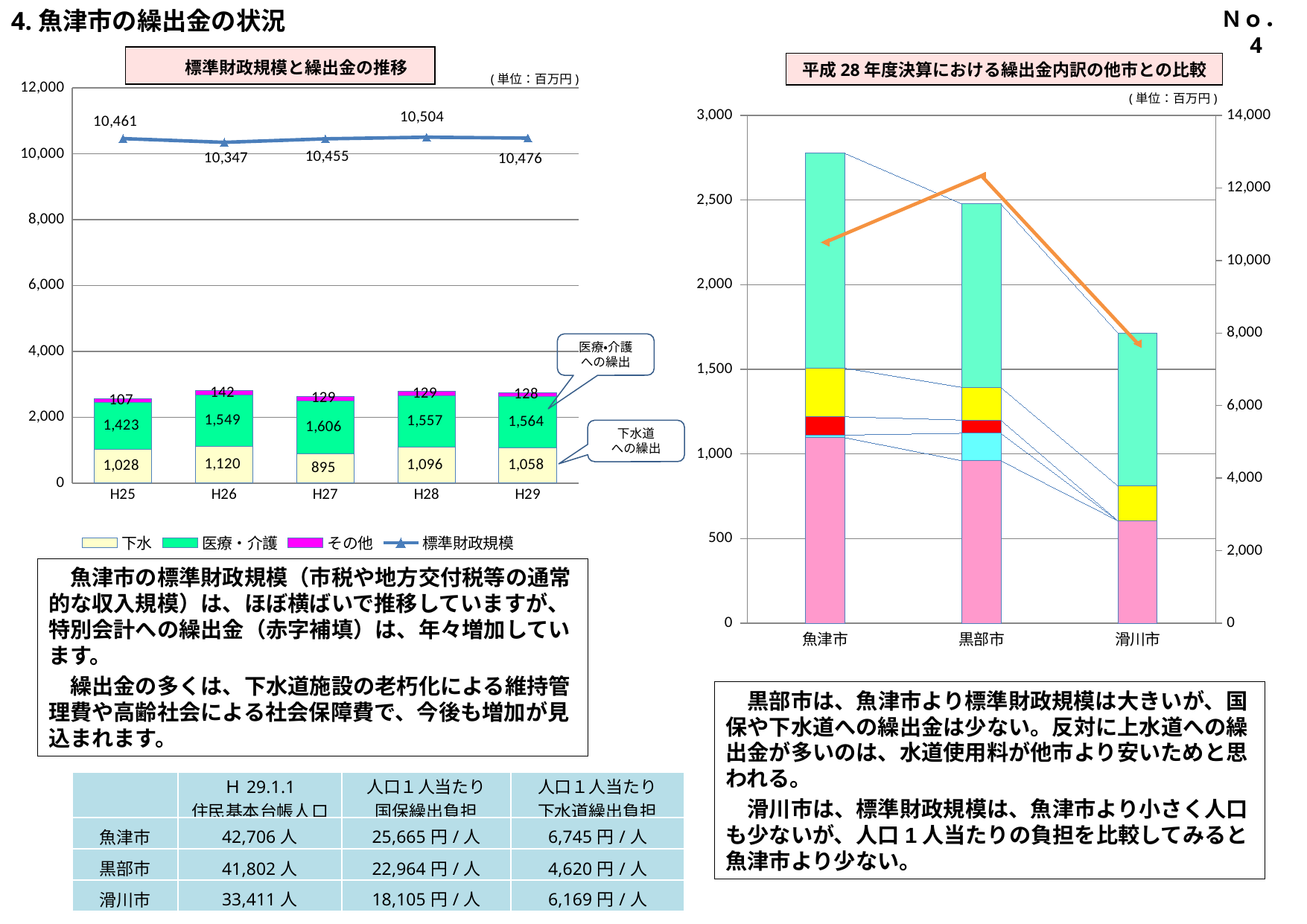
In the left chart (標準財政規模と繰出金の推移), what is the 下水 value for H27? 895 In the left chart (標準財政規模と繰出金の推移), what is the 医療・介護 value for H26? 1,549 What kind of chart is the right chart (平成28年度決算における繰出金内訳の他市との比較)? A stacked bar chart with a line In the left chart (標準財政規模と繰出金の推移), how many series does the legend list? 4 In the right chart (平成28年度決算における繰出金内訳の他市との比較), is the total height of the 魚津市 bar greater or less than 2,500 on the left axis? greater In the right chart (平成28年度決算における繰出金内訳の他市との比較), which city has the taller stacked bar, 魚津市 or 滑川市? 魚津市 In the left chart (標準財政規模と繰出金の推移), what is the value of 標準財政規模 for H25? 10,461 In the left chart (標準財政規模と繰出金の推移), in which year is 標準財政規模 highest? H28 In the left chart (標準財政規模と繰出金の推移), what is the difference between the 医療・介護 values for H27 and H25? 183 In the left chart (標準財政規模と繰出金の推移), in which year is the 下水 value lowest? H27 In the left chart (標準財政規模と繰出金の推移), how many years are shown on the x axis? 5 In the left chart (標準財政規模と繰出金の推移), what is the total of the stacked bar for H25 (下水 + 医療・介護 + その他)? 2,558